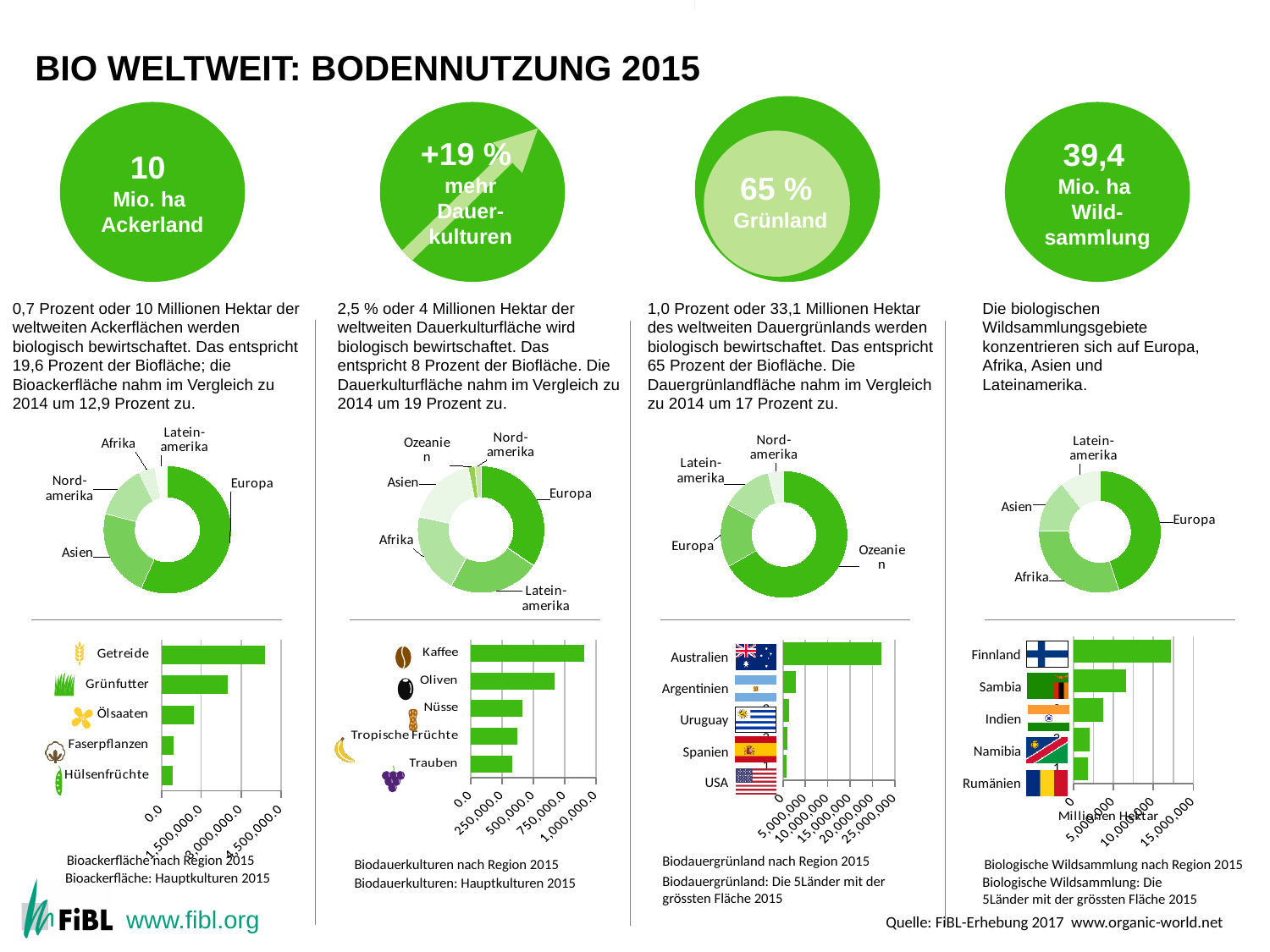
In the chart 'Biodauergrünland nach Region 2015', which region has the largest share? Ozeanien In the chart 'Biodauergrünland: Die 5 Länder mit der grössten Fläche 2015', which country has the highest value? Australien In the chart 'Biodauergrünland: Die 5 Länder mit der grössten Fläche 2015', is the value for Australien greater or less than 20,000,000? greater In the chart 'Biodauerkulturen: Hauptkulturen 2015', is the value for Kaffee greater or less than 750,000.0? greater What type of chart is 'Biodauerkulturen nach Region 2015'? Donut chart In the chart 'Bioackerfläche: Hauptkulturen 2015', is the value for Ölsaaten greater or less than 1,000,000.0? greater How many regions are shown in the chart 'Bioackerfläche nach Region 2015'? 5 In the chart 'Bioackerfläche nach Region 2015', which region has the largest share? Europa